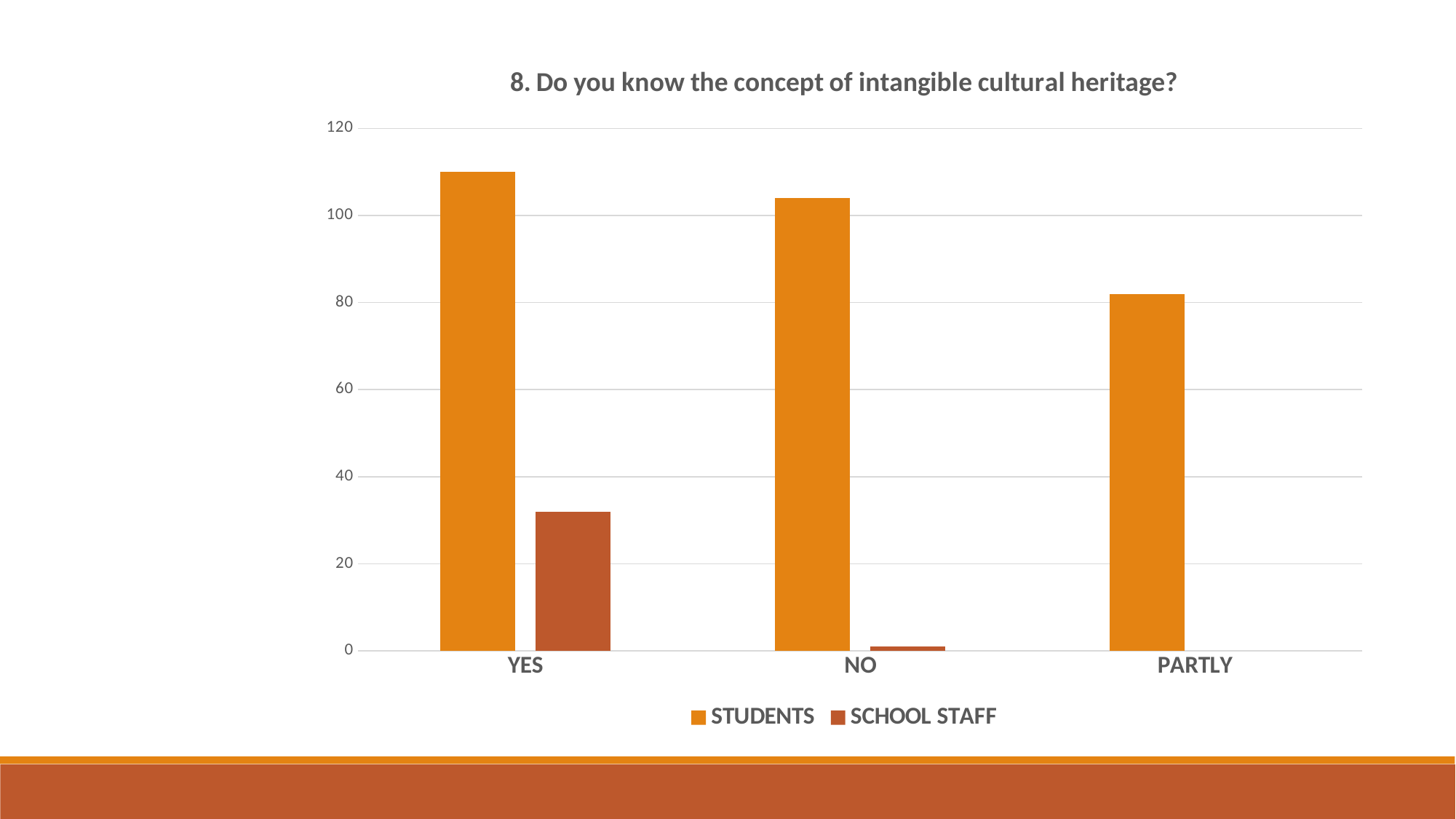
Which category has the highest value for SCHOOL STAFF? YES What kind of chart is shown on the slide? bar chart Is the SCHOOL STAFF value for YES greater or less than 40? less Is the SCHOOL STAFF value for NO greater or less than 20? less Is the STUDENTS value for YES greater or less than 100? greater Which category has the lowest value for STUDENTS? PARTLY How many series does the legend list? 2 For the YES category, which series has the larger value, STUDENTS or SCHOOL STAFF? STUDENTS How many categories are shown on the x axis? 3 Which series is shown in the darker red-brown colour? SCHOOL STAFF What is the title of the chart? 8. Do you know the concept of intangible cultural heritage?